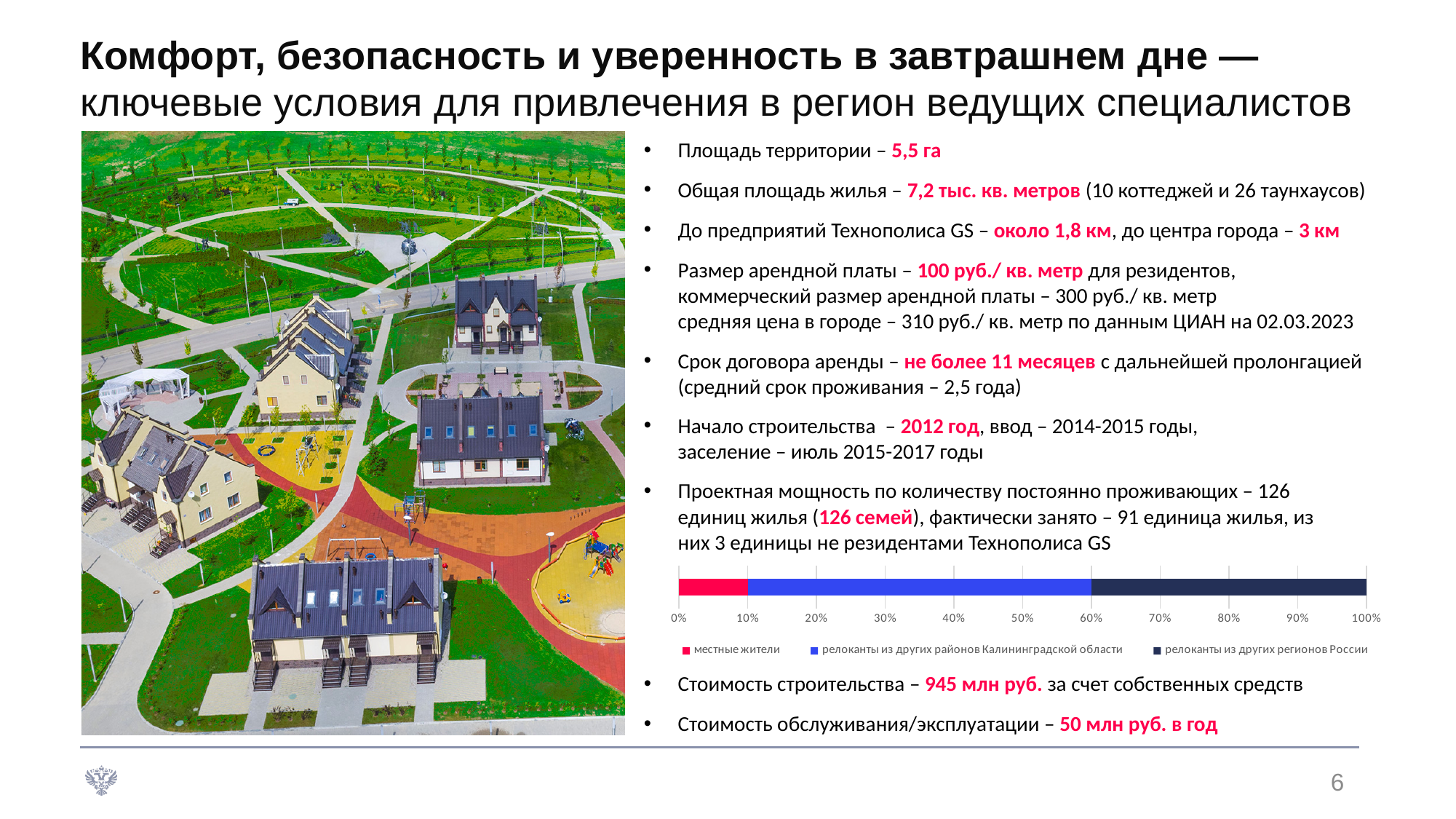
Which series takes up the smallest share of the bar? местные жители Is the share for 'релоканты из других регионов России' greater or less than 30%? greater How many series does the chart's legend list? 3 Is the share for 'релоканты из других районов Калининградской области' greater or less than 40%? greater What colour represents 'местные жители' in the chart? red What is the highest value shown on the chart's horizontal axis? 100% How many bars does the chart contain? 1 Which series takes up the largest share of the bar? релоканты из других районов Калининградской области Which is larger: the share for 'релоканты из других районов Калининградской области' or the share for 'релоканты из других регионов России'? релоканты из других районов Калининградской области What kind of chart is shown on the slide? bar chart Is the share for 'местные жители' greater or less than 20%? less Which is larger: the share for 'местные жители' or the share for 'релоканты из других районов Калининградской области'? релоканты из других районов Калининградской области